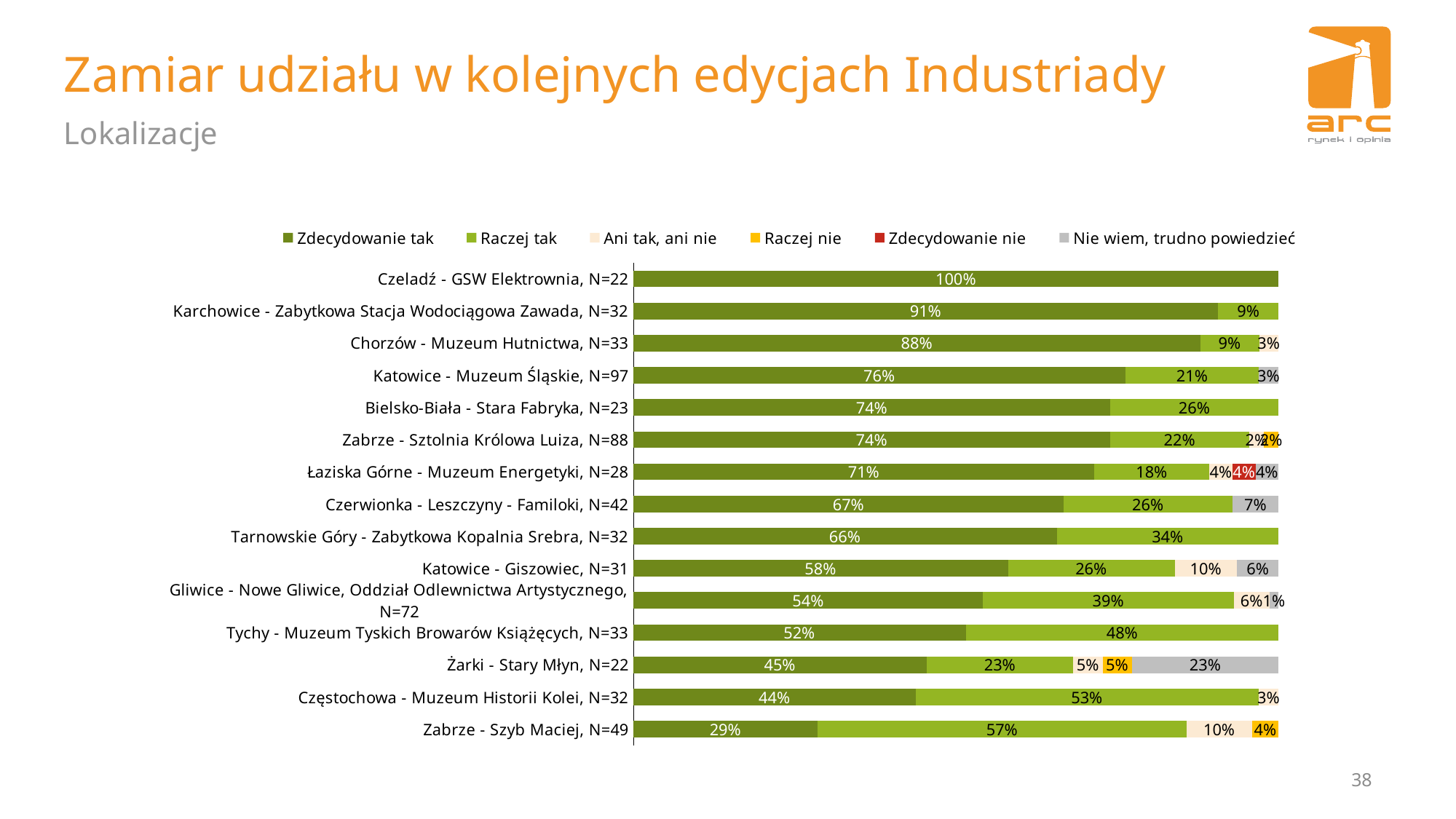
What kind of chart is shown on the slide? Stacked bar chart What is the value of "Nie wiem, trudno powiedzieć" for Żarki - Stary Młyn, N=22? 23% What is the value of "Zdecydowanie tak" for Katowice - Muzeum Śląskie, N=97? 76% How many series does the legend list? 6 How many locations are shown in the chart? 15 Which has a larger "Raczej tak" value: Częstochowa - Muzeum Historii Kolei, N=32 or Zabrze - Szyb Maciej, N=49? Zabrze - Szyb Maciej, N=49 What is the title of the slide? Zamiar udziału w kolejnych edycjach Industriady What is the difference in "Zdecydowanie tak" between Karchowice - Zabytkowa Stacja Wodociągowa Zawada, N=32 and Chorzów - Muzeum Hutnictwa, N=33? 3 percentage points Which location has the lowest "Zdecydowanie tak" value? Zabrze - Szyb Maciej, N=49 What is the value of "Zdecydowanie nie" for Łaziska Górne - Muzeum Energetyki, N=28? 4% What is the value of "Raczej tak" for Tychy - Muzeum Tyskich Browarów Książęcych, N=33? 48% Which location has the highest "Zdecydowanie tak" value? Czeladź - GSW Elektrownia, N=22